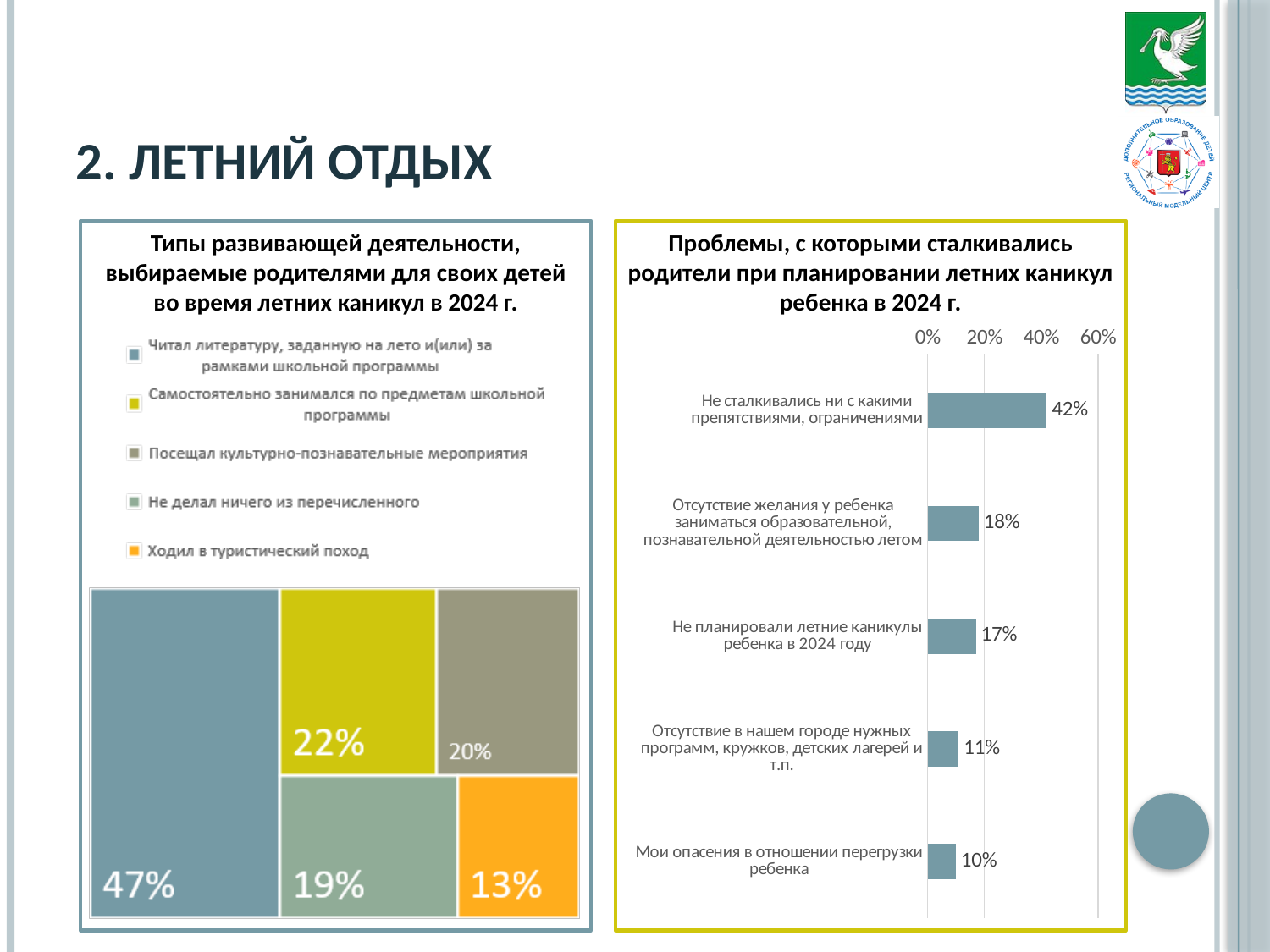
In the chart 'Типы развивающей деятельности, выбираемые родителями для своих детей во время летних каникул в 2024 г.', what is the value for 'Ходил в туристический поход'? 13% In the chart 'Типы развивающей деятельности, выбираемые родителями для своих детей во время летних каникул в 2024 г.', what is the value for 'Читал литературу, заданную на лето и(или) за рамками школьной программы'? 47% In the chart 'Проблемы, с которыми сталкивались родители при планировании летних каникул ребенка в 2024 г.', what is the value for 'Мои опасения в отношении перегрузки ребенка'? 10% What kind of chart is 'Проблемы, с которыми сталкивались родители при планировании летних каникул ребенка в 2024 г.'? Bar chart In the chart 'Проблемы, с которыми сталкивались родители при планировании летних каникул ребенка в 2024 г.', is the value for 'Отсутствие желания у ребенка заниматься образовательной, познавательной деятельностью летом' greater or less than 20%? less In the chart 'Проблемы, с которыми сталкивались родители при планировании летних каникул ребенка в 2024 г.', how many categories are shown? 5 In the chart 'Типы развивающей деятельности, выбираемые родителями для своих детей во время летних каникул в 2024 г.', which is larger: 'Самостоятельно занимался по предметам школьной программы' or 'Не делал ничего из перечисленного'? Самостоятельно занимался по предметам школьной программы In the chart 'Проблемы, с которыми сталкивались родители при планировании летних каникул ребенка в 2024 г.', what is the difference between 'Не сталкивались ни с какими препятствиями, ограничениями' and 'Не планировали летние каникулы ребенка в 2024 году'? 25% In the chart 'Проблемы, с которыми сталкивались родители при планировании летних каникул ребенка в 2024 г.', which category has the lowest value? Мои опасения в отношении перегрузки ребенка In the chart 'Проблемы, с которыми сталкивались родители при планировании летних каникул ребенка в 2024 г.', which category has the highest value? Не сталкивались ни с какими препятствиями, ограничениями In the chart 'Проблемы, с которыми сталкивались родители при планировании летних каникул ребенка в 2024 г.', what is the value for 'Не сталкивались ни с какими препятствиями, ограничениями'? 42% How many entries does the legend of the chart 'Типы развивающей деятельности, выбираемые родителями для своих детей во время летних каникул в 2024 г.' list? 5